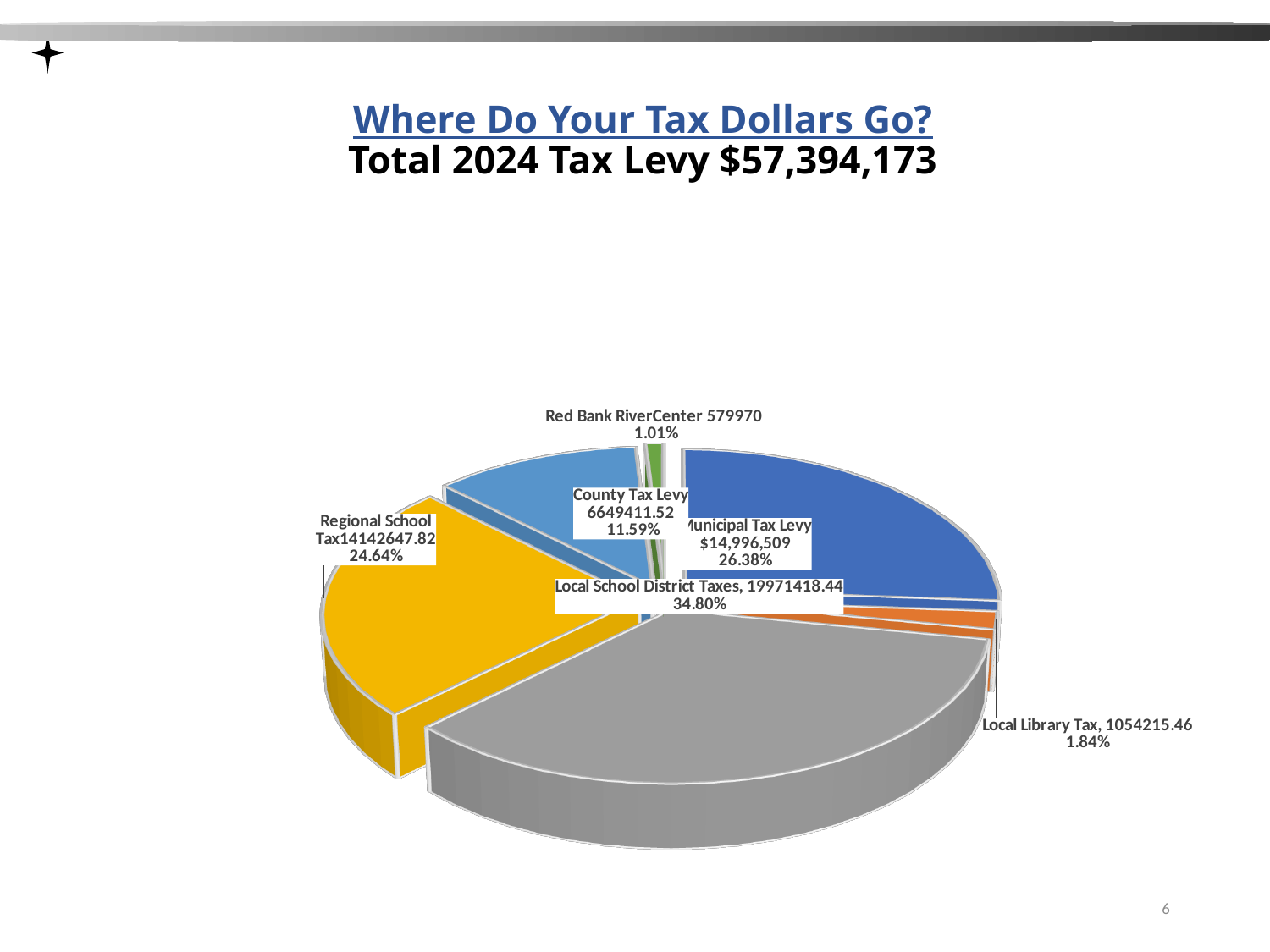
What kind of chart is shown on the slide? Pie chart What value is shown for the County Tax Levy slice? 6649411.52 What percentage share is shown for Regional School Tax? 24.64% What percentage share is shown for the Municipal Tax Levy? 26.38% What is the difference in percentage points between the Local School District Taxes share and the County Tax Levy share? 23.21% Which slice of the pie chart is the largest? Local School District Taxes Which is larger, the Municipal Tax Levy share or the Regional School Tax share? Municipal Tax Levy What percentage of the tax levy goes to Local School District Taxes? 34.80% What total 2024 tax levy is stated in the slide title? $57,394,173 Which slice of the pie chart is the smallest? Red Bank RiverCenter How many slices does the pie chart have? 6 What is the value shown for the Municipal Tax Levy slice? $14,996,509